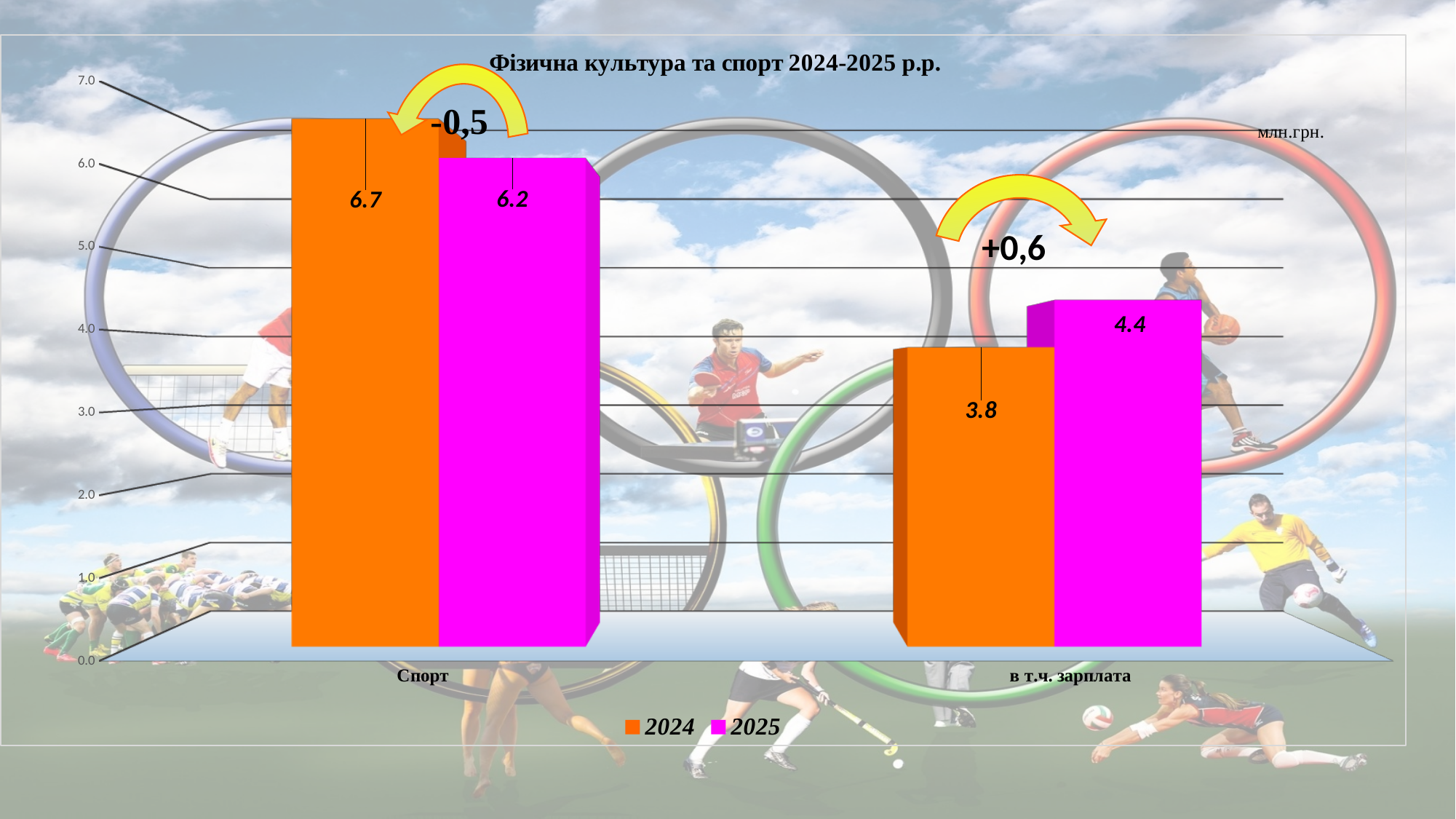
What is the value for Спорт in 2024? 6.7 What is the title of the chart? Фізична культура та спорт 2024-2025 р.р. What kind of chart is shown on the slide? Bar chart What is the value for Спорт in 2025? 6.2 Which category has the highest value in the 2025 series? Спорт Which is larger for в т.ч. зарплата: the 2024 value or the 2025 value? 2025 Which category has the lowest value in the 2024 series? в т.ч. зарплата What is the difference between the 2024 and 2025 values for Спорт? 0.5 What is the value for в т.ч. зарплата in 2024? 3.8 What is the difference between the 2025 and 2024 values for в т.ч. зарплата? 0.6 What is the value for в т.ч. зарплата in 2025? 4.4 How many series does the legend list? 2